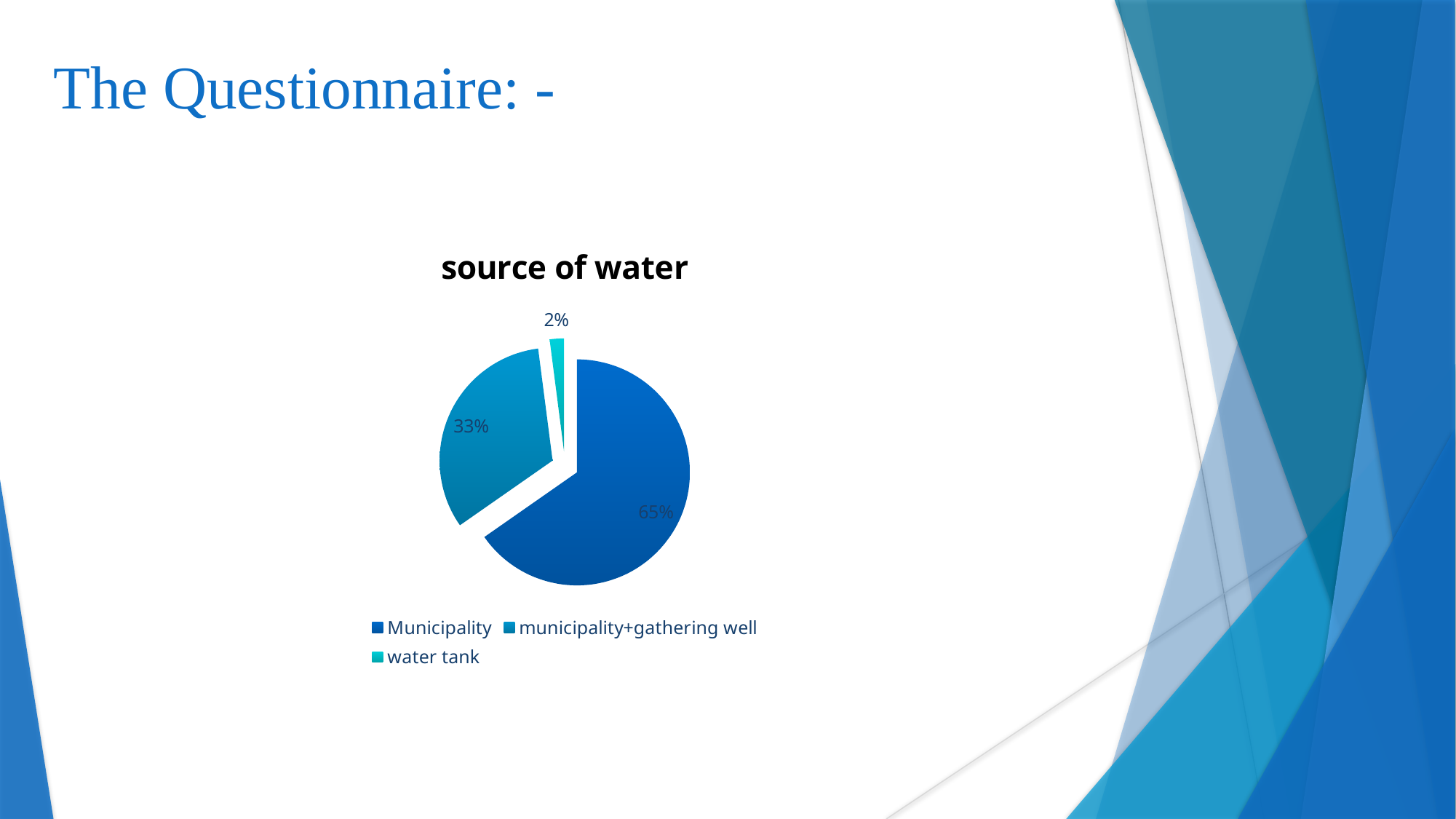
Which is larger, the share for municipality+gathering well or the share for water tank? municipality+gathering well What is the difference in percentage points between Municipality and municipality+gathering well? 32 What type of chart is shown on the slide? pie chart What percentage of the pie is municipality+gathering well? 33% What percentage of the pie is Municipality? 65% Which category has the largest share of the pie? Municipality What is the difference in percentage points between municipality+gathering well and water tank? 31 How many entries does the legend list? 3 Which category has the smallest share of the pie? water tank How many categories does the pie chart show? 3 What percentage of the pie is water tank? 2% What is the title of the chart? source of water